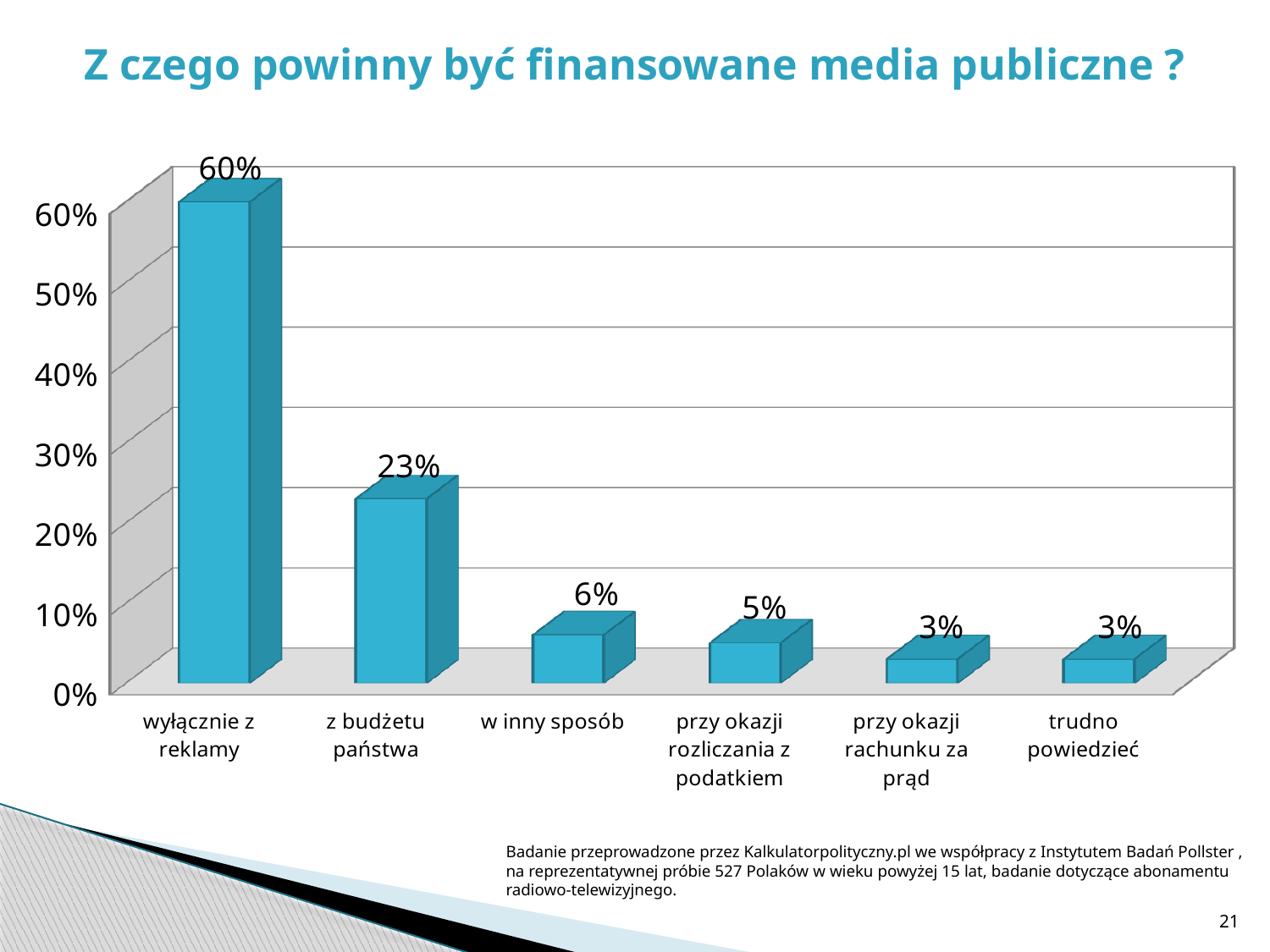
Which category has the highest value? wyłącznie z reklamy What is the difference between the values for "wyłącznie z reklamy" and "z budżetu państwa"? 37% What is the value for "w inny sposób"? 6% What is the title of the chart? Z czego powinny być finansowane media publiczne ? How many categories are shown on the x axis? 6 What is the value for "przy okazji rozliczania z podatkiem"? 5% What is the value for "wyłącznie z reklamy"? 60% What kind of chart is shown on the slide? bar chart Is the value for "z budżetu państwa" greater or less than 30%? less What is the value for "z budżetu państwa"? 23% Do the values rise or fall from left to right along the x axis? fall Which is larger, the value for "w inny sposób" or the value for "przy okazji rozliczania z podatkiem"? w inny sposób